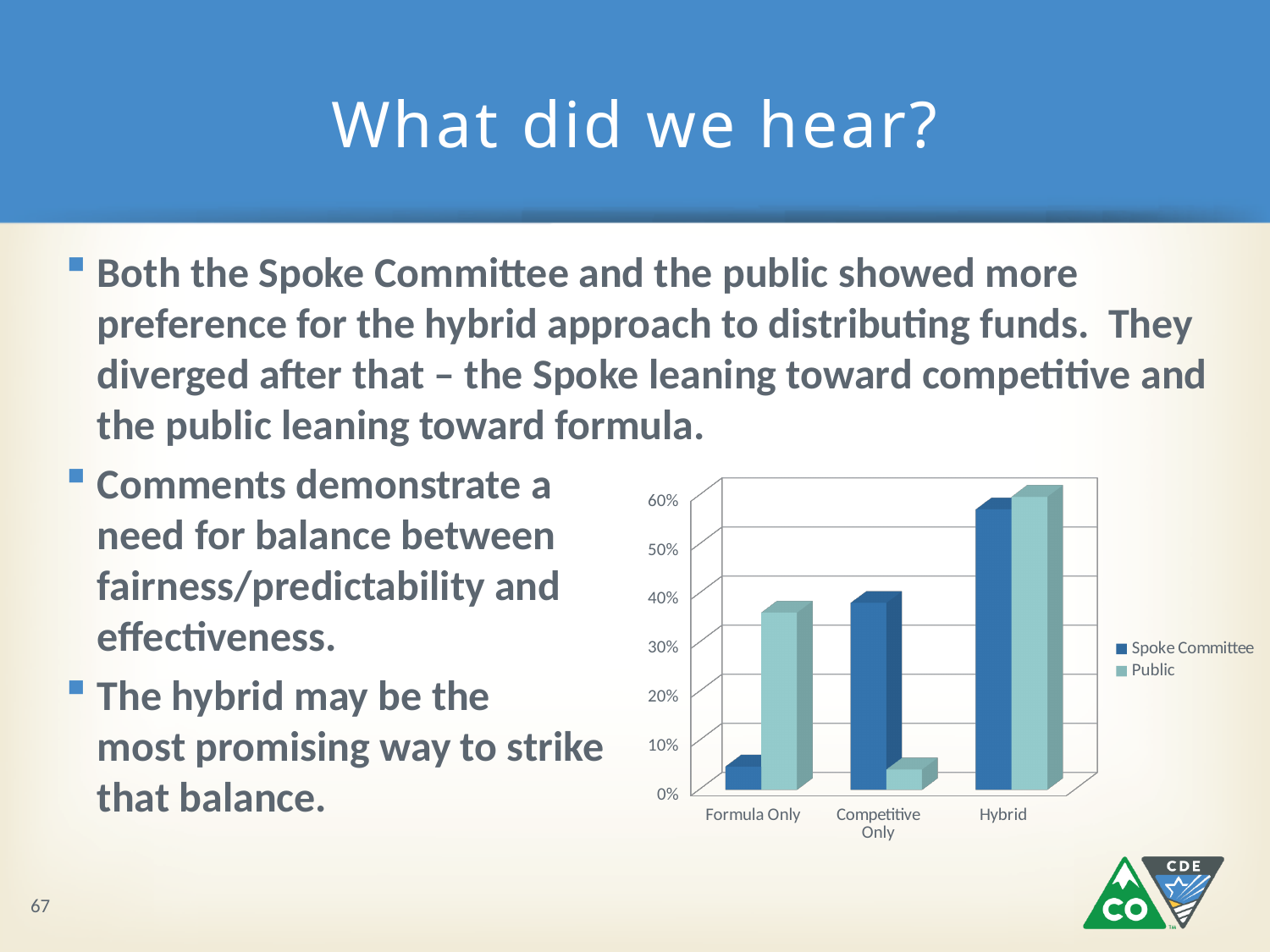
Is the Spoke Committee value for Formula Only greater or less than 10%? less Which category has the highest value for the Public series? Hybrid Which category has the lowest value for the Public series? Competitive Only Is the Spoke Committee value for Hybrid greater or less than 50%? greater Which series is shown in the darker blue bars? Spoke Committee Is the Public value for Formula Only greater or less than 30%? greater How many categories are shown on the x axis of the chart? 3 Which category has the highest value for the Spoke Committee series? Hybrid For Competitive Only, which is larger: the Spoke Committee value or the Public value? Spoke Committee What kind of chart is shown on the slide? bar chart How many series does the chart's legend list? 2 Which category has the lowest value for the Spoke Committee series? Formula Only